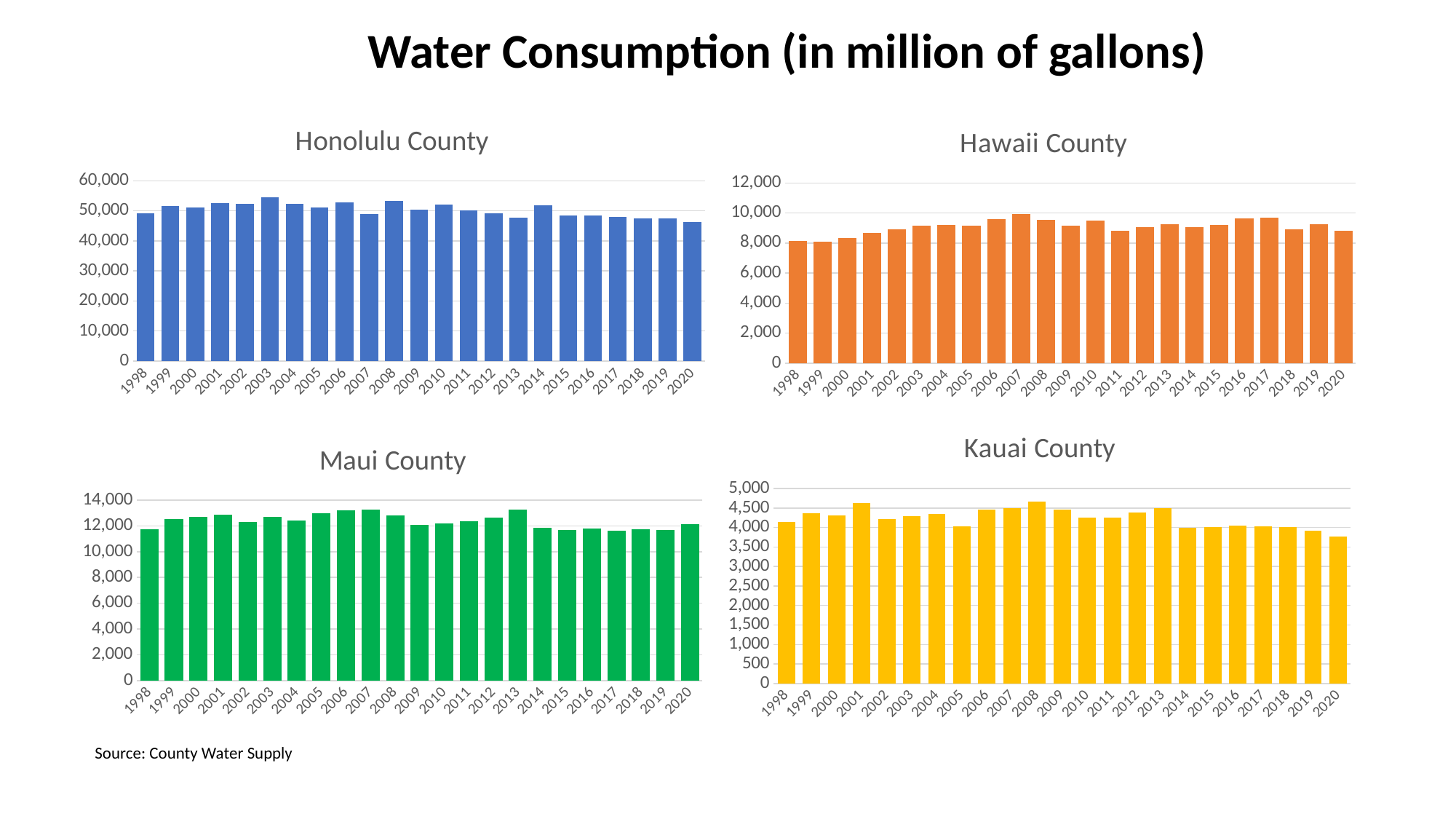
On the Honolulu County chart, is the value for 2020 greater or less than 50,000? less On the Hawaii County chart, which year has the highest water consumption? 2007 On the Kauai County chart, which year has the lowest water consumption? 2020 On the Honolulu County chart, which year has the highest water consumption? 2003 What kind of chart is the Honolulu County chart? bar chart On the Kauai County chart, do the values rise or fall from 2013 to 2020? fall On the Honolulu County chart, which year has the lowest water consumption? 2020 On the Hawaii County chart, which is larger, the value for 2007 or the value for 1999? 2007 On the Kauai County chart, is the value for 2020 greater or less than 4,000? less What is the overall title of the slide's charts? Water Consumption (in million of gallons) How many years are plotted on the Hawaii County chart? 23 On the Maui County chart, is the value for 2006 greater or less than 12,000? greater